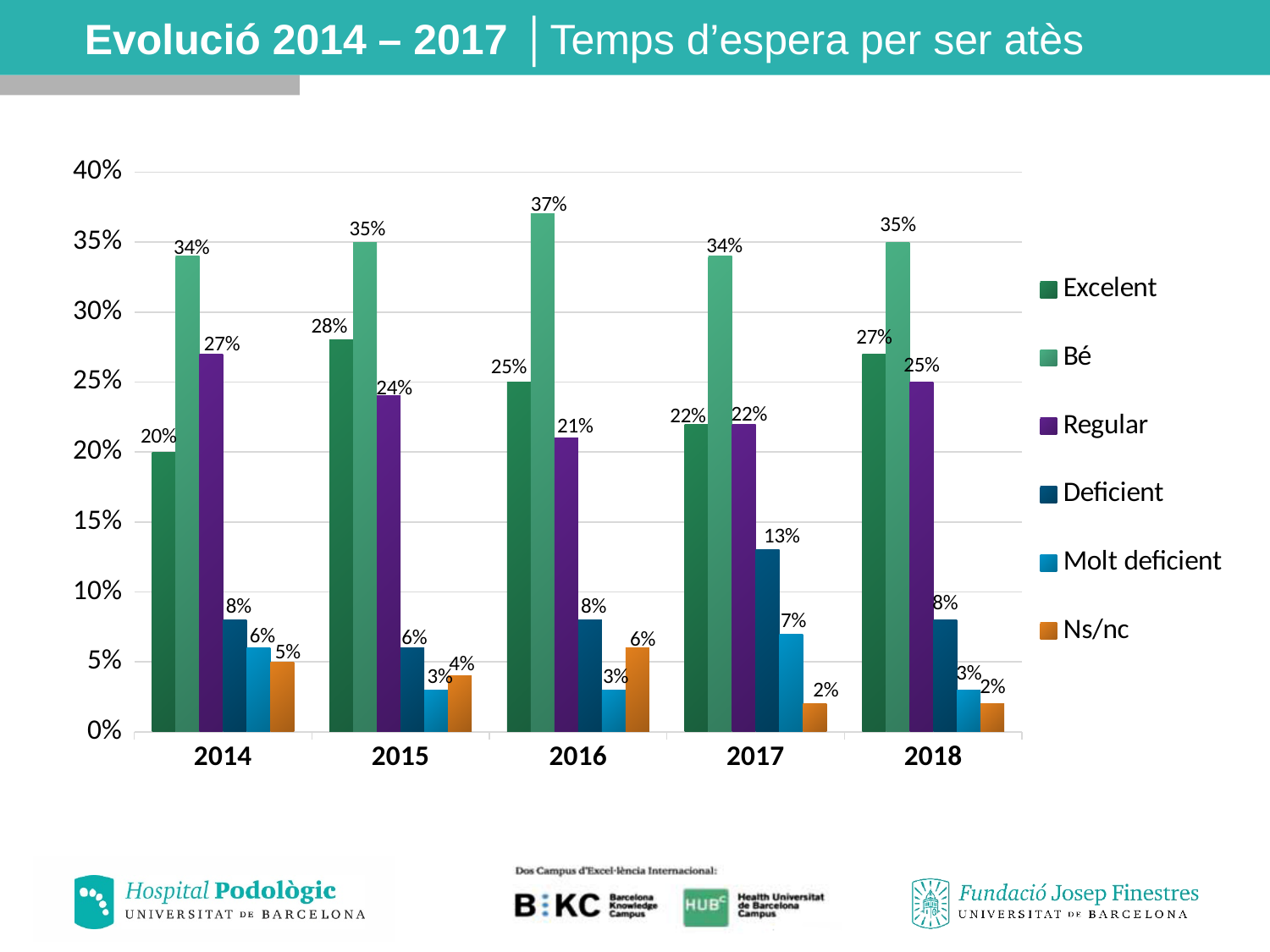
What kind of chart is shown on the slide? Bar chart Which is larger in 2018: Regular or Excelent? Excelent How many series does the legend list? 6 What is the value for Deficient in 2017? 13% What is the difference between the Bé and Excelent values in 2014? 14% Which series is shown in orange in the legend? Ns/nc In which year is the Bé value highest? 2016 In which year is the Excelent value lowest? 2014 What is the value for Excelent in 2015? 28% How many years are shown on the x axis? 5 What is the value for Ns/nc in 2018? 2% What is the value for Bé in 2016? 37%